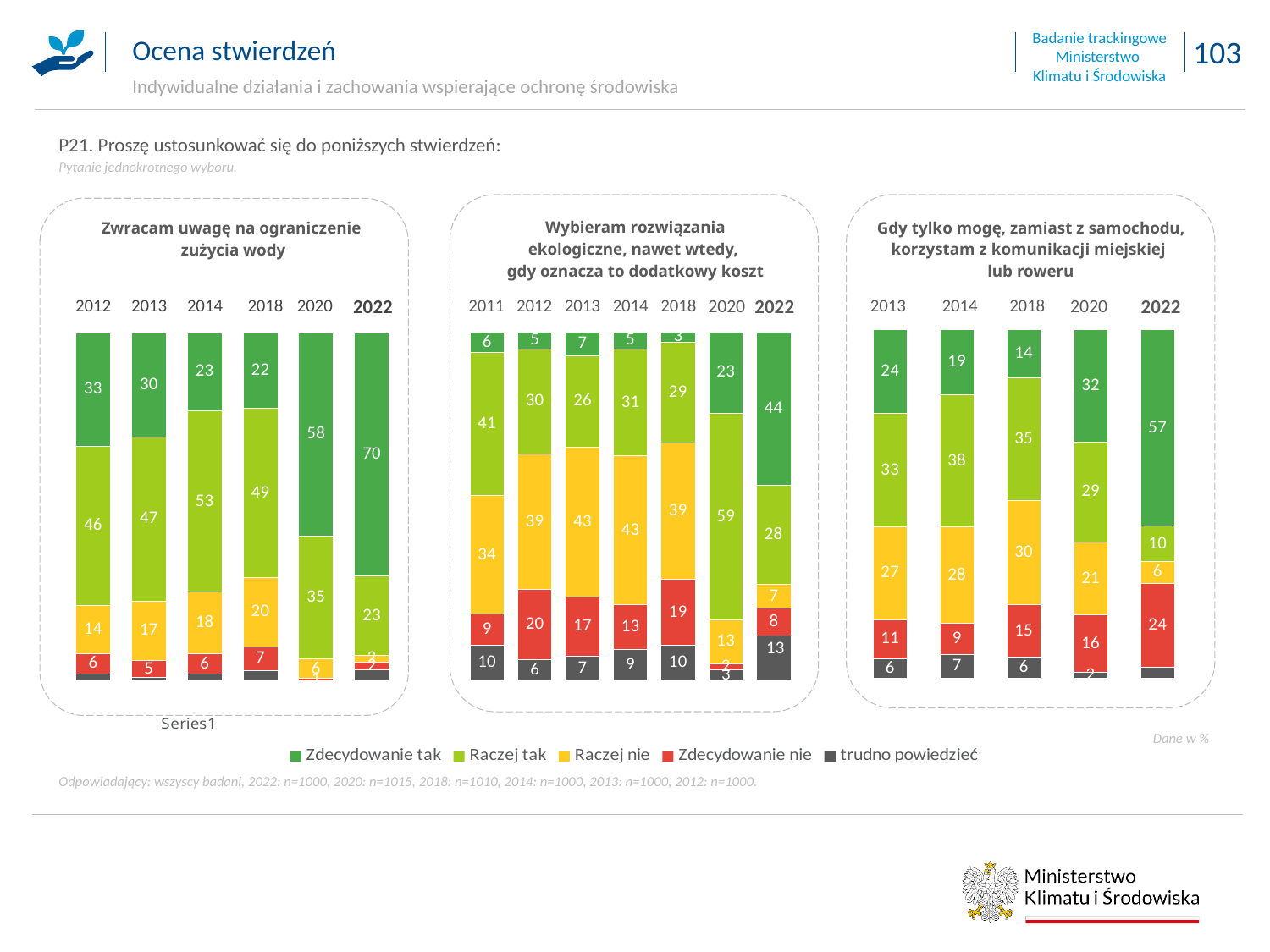
In the chart 'Zwracam uwagę na ograniczenie zużycia wody', what is the value for 'Zdecydowanie tak' in 2022? 70 In the chart 'Gdy tylko mogę, zamiast z samochodu, korzystam z komunikacji miejskiej lub roweru', by how much did 'Zdecydowanie tak' increase from 2020 to 2022? 25 In the chart 'Wybieram rozwiązania ekologiczne, nawet wtedy, gdy oznacza to dodatkowy koszt', which year has the lowest value for 'Zdecydowanie tak'? 2018 How many series does the legend at the bottom of the slide list? 5 In the chart 'Wybieram rozwiązania ekologiczne, nawet wtedy, gdy oznacza to dodatkowy koszt', what is the value for 'Raczej nie' in 2013? 43 In the chart 'Gdy tylko mogę, zamiast z samochodu, korzystam z komunikacji miejskiej lub roweru', what is the value for 'Zdecydowanie nie' in 2022? 24 What kind of chart is used for 'Zwracam uwagę na ograniczenie zużycia wody'? Stacked bar chart In the chart 'Wybieram rozwiązania ekologiczne, nawet wtedy, gdy oznacza to dodatkowy koszt', which year has the larger value for 'Raczej tak', 2020 or 2022? 2020 How many years are shown in the chart 'Wybieram rozwiązania ekologiczne, nawet wtedy, gdy oznacza to dodatkowy koszt'? 7 In the chart 'Zwracam uwagę na ograniczenie zużycia wody', does the value for 'Zdecydowanie tak' rise or fall from 2018 to 2022? Rises In the chart 'Wybieram rozwiązania ekologiczne, nawet wtedy, gdy oznacza to dodatkowy koszt', what is the total of the 2022 bar? 100 In the chart 'Zwracam uwagę na ograniczenie zużycia wody', which year has the highest value for 'Zdecydowanie tak'? 2022